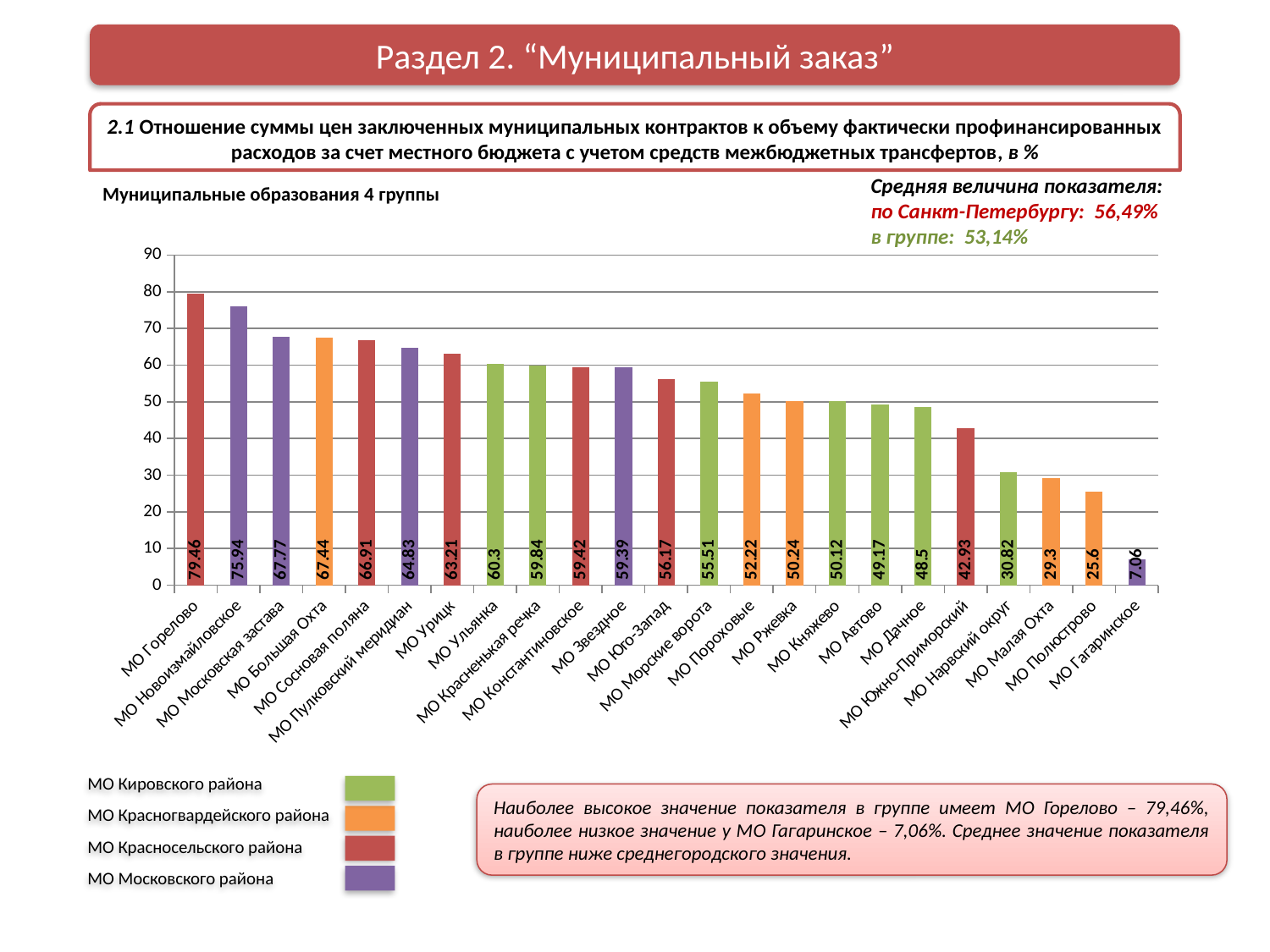
What is the value for МО Пороховые? 52.22 Which municipality has the highest value on the chart? МО Горелово What is the value for МО Горелово? 79.46 What is the difference between the values for МО Новоизмайловское and МО Московская застава? 8.17 How many district groups does the legend list? 4 Which is larger, the value for МО Урицк or the value for МО Ульянка? МО Урицк How many municipalities are shown on the chart? 23 What is the difference between the values for МО Горелово and МО Гагаринское? 72.4 What kind of chart is shown on the slide? bar chart Which municipality has the lowest value on the chart? МО Гагаринское What is the value for МО Южно-Приморский? 42.93 Is the value for МО Нарвский округ greater or less than 40? less